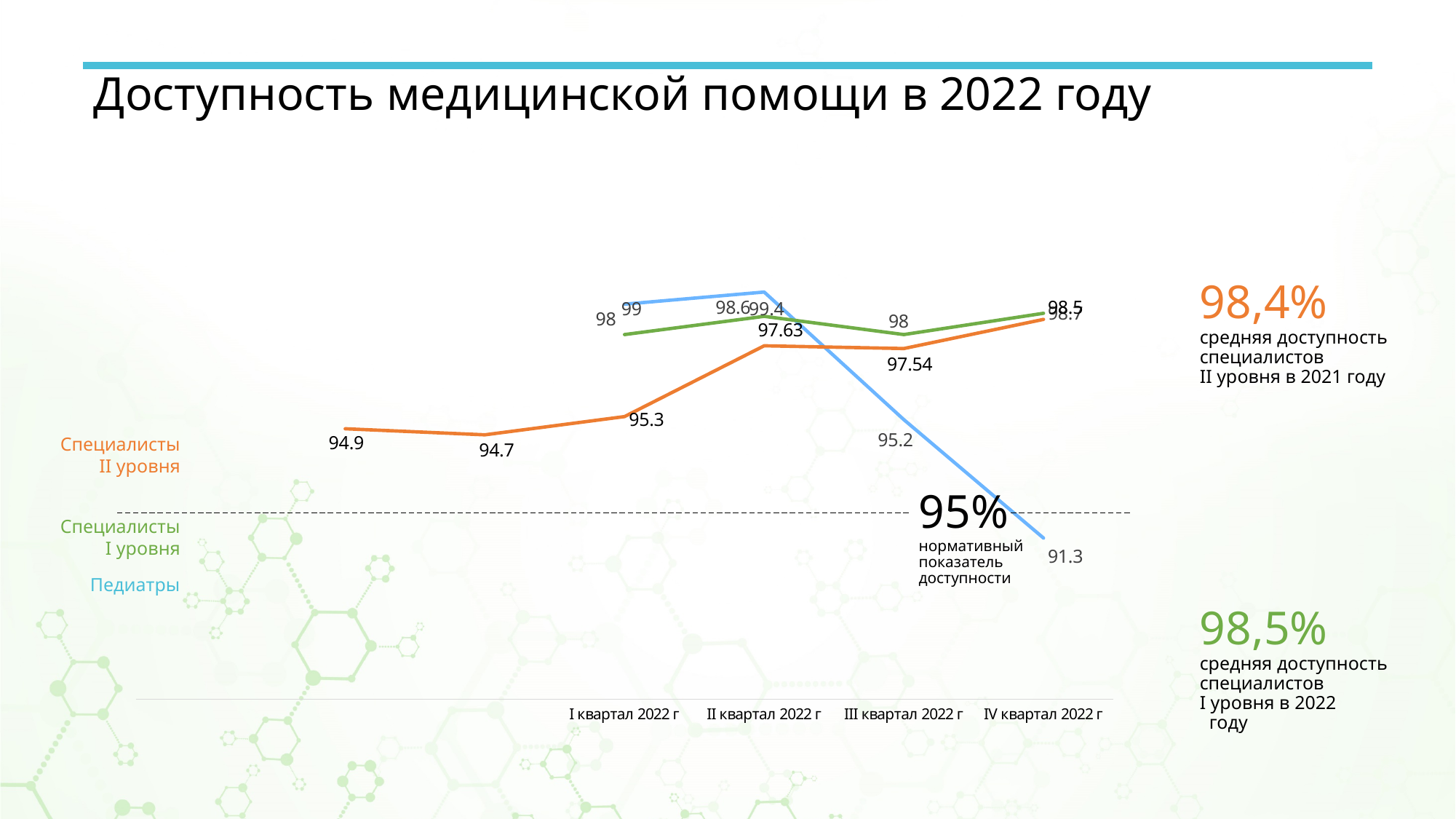
How many series are plotted on the chart? 3 What is the value for Специалисты II уровня in II квартал 2022 г? 97.63 Which is larger in IV квартал 2022 г: the value for Педиатры or for Специалисты II уровня? Специалисты II уровня What is the difference between the Педиатры values in I квартал 2022 г (99) and IV квартал 2022 г (91.3)? 7.7 What is the value for Педиатры in III квартал 2022 г? 95.2 In which quarter is the value for Педиатры lowest? IV квартал 2022 г Do the values for Педиатры rise or fall from I квартал 2022 г to IV квартал 2022 г? fall What is the value for Специалисты II уровня in III квартал 2022 г? 97.54 What kind of chart is shown on the slide? line chart How many quarters are labelled on the x axis? 4 What is the value for Педиатры in IV квартал 2022 г? 91.3 What is the value for Специалисты I уровня in III квартал 2022 г? 98